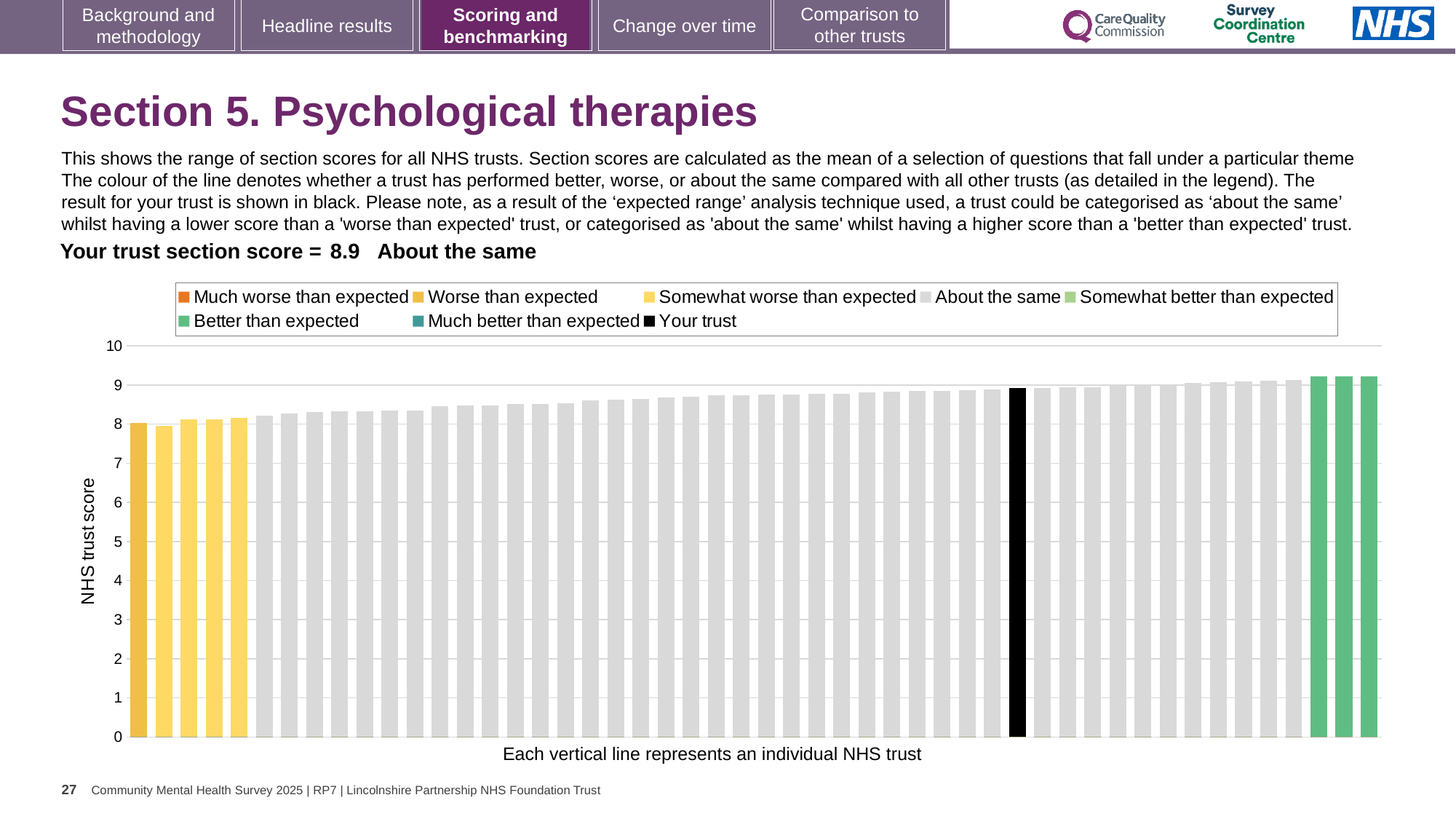
Is the value of the black 'Your trust' bar greater or less than 8? greater Which category is your trust's section score placed in? About the same What kind of chart is shown on the slide? Bar chart Is the black 'Your trust' bar higher or lower than the leftmost bar? Higher How many entries does the chart legend list? 8 How many bars are coloured green (Better than expected)? 3 Is the value of the rightmost bar greater or less than 9? greater What colour is the bar representing your trust? Black What is the section score for your trust shown on the slide? 8.9 What is the label on the vertical axis of the chart? NHS trust score Is the value of the leftmost bar greater or less than 9? less Do the bar values rise or fall from left to right across the chart? Rise